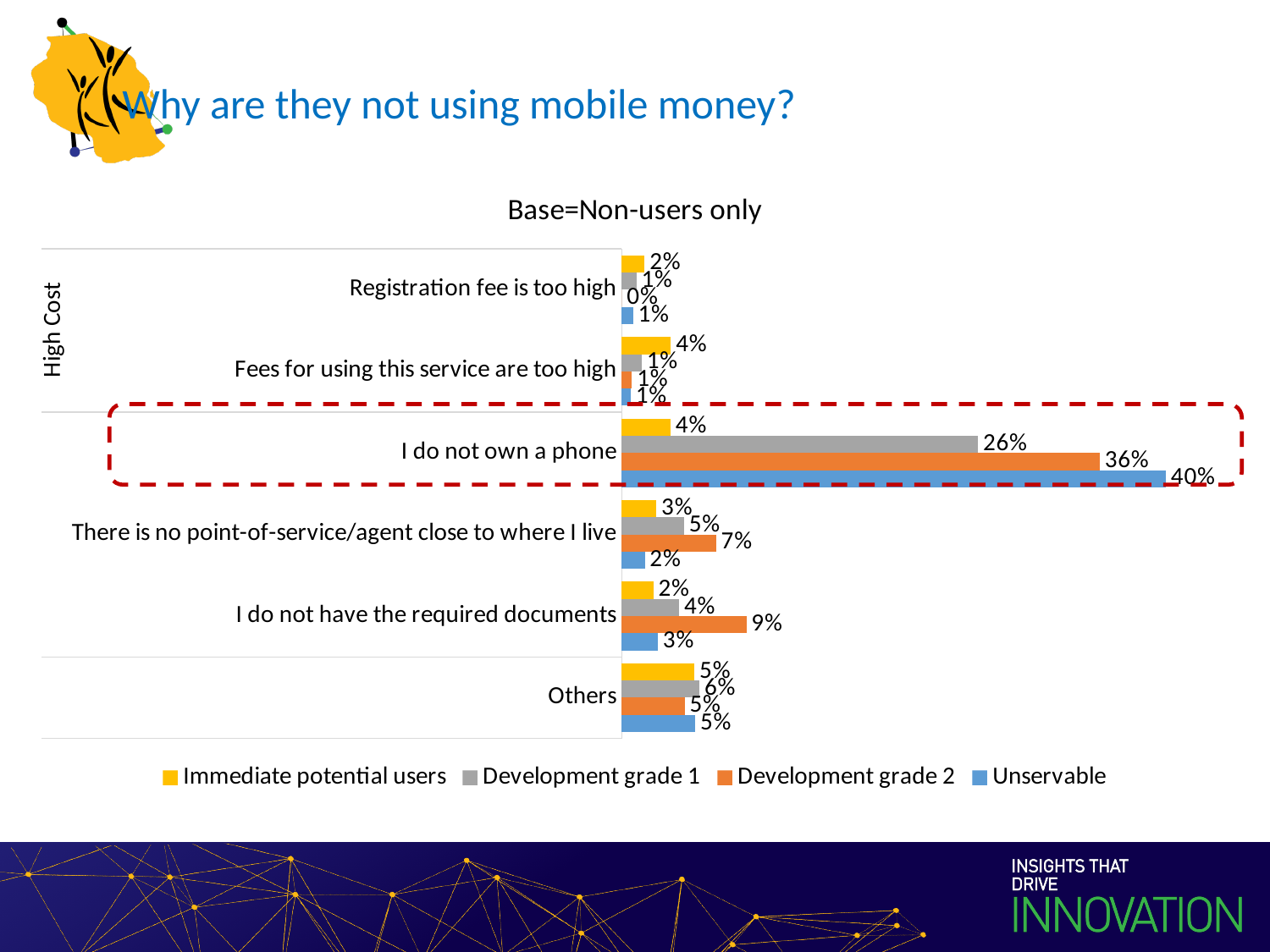
What kind of chart is shown on the slide? bar chart How many series does the legend list? 4 What is the difference between the Unservable and Immediate potential users values for "I do not own a phone"? 36% What is the title of the chart? Base=Non-users only What is the value for Development grade 2 for "Registration fee is too high"? 0% Which is larger for "There is no point-of-service/agent close to where I live": Development grade 2 or Unservable? Development grade 2 What is the value for Development grade 2 for "I do not have the required documents"? 9% What is the value for Development grade 2 for "I do not own a phone"? 36% What is the value for Development grade 1 for "I do not own a phone"? 26% What is the value for Unservable for "I do not own a phone"? 40% Which category has the highest value for Unservable? I do not own a phone How many reason categories are plotted on the chart? 6